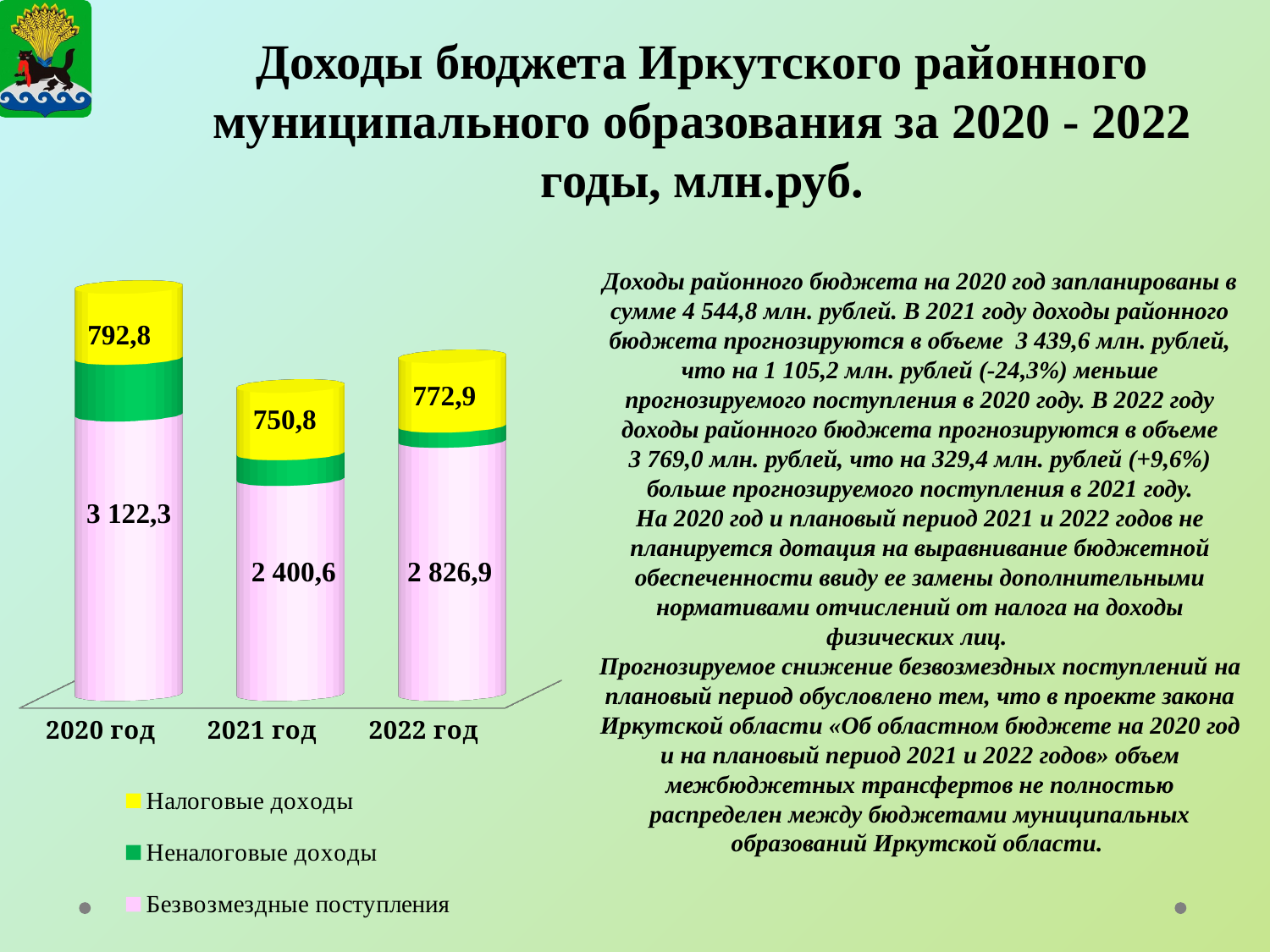
Which year has the larger value of Налоговые доходы, 2021 год or 2022 год? 2022 год In which year is the value of Налоговые доходы the lowest? 2021 год What is the value of Безвозмездные поступления for 2021 год? 2 400,6 How many years are shown on the x axis of the chart? 3 What is the value of Налоговые доходы for 2020 год? 792,8 What is the value of Безвозмездные поступления for 2022 год? 2 826,9 What is the value of Налоговые доходы for 2022 год? 772,9 In which year is the value of Безвозмездные поступления the highest? 2020 год By how much does Безвозмездные поступления in 2020 год exceed that in 2021 год? 721,7 What kind of chart is shown on the slide? Stacked bar chart How many series does the legend list? 3 What is the difference between Налоговые доходы in 2020 год and in 2022 год? 19,9